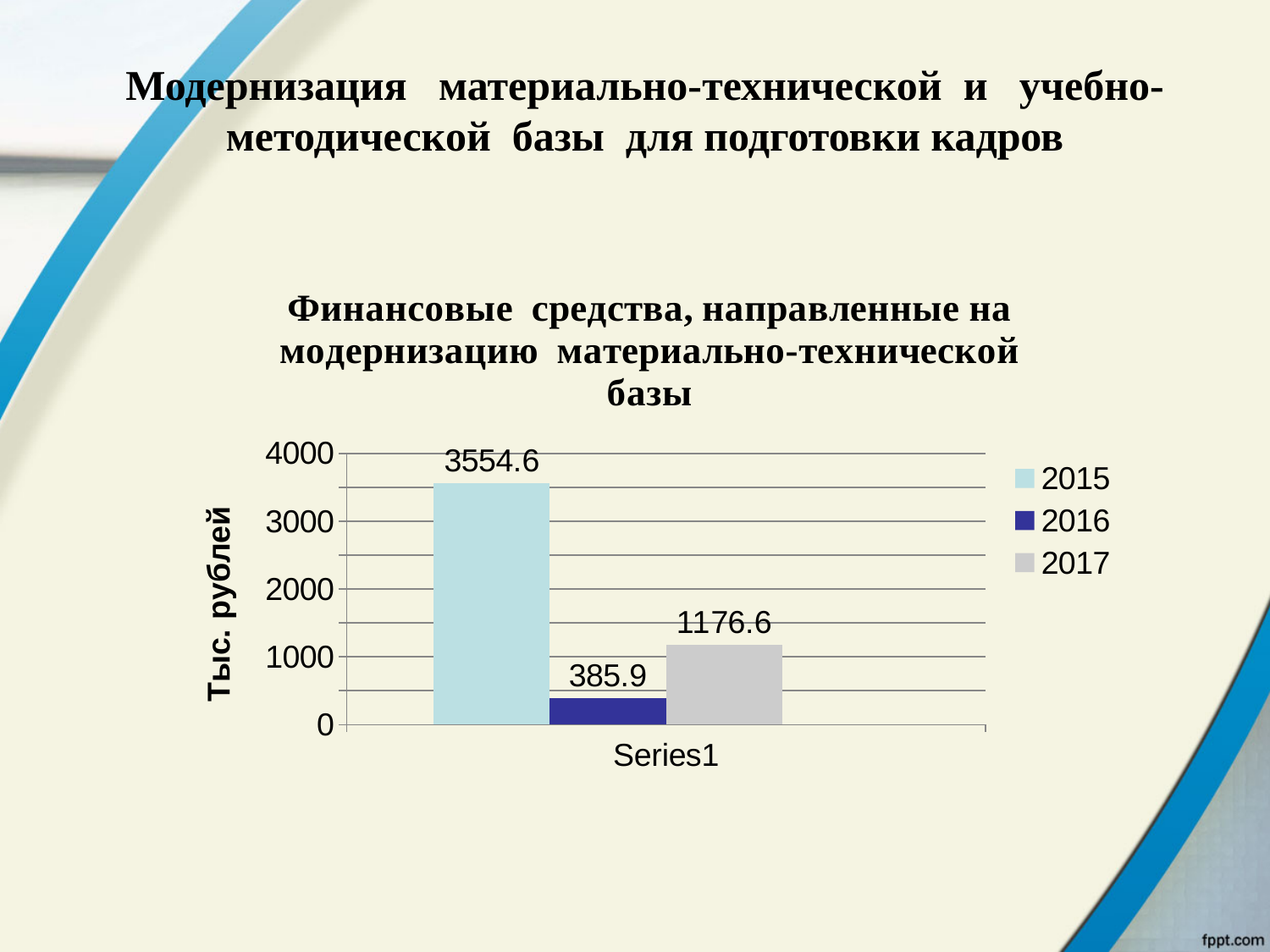
Is the value for 2015 greater or less than 3000? greater How many series does the legend list? 3 What is the value for 2015? 3554.6 Which year has the lowest value? 2016 What is the difference between the values for 2017 and 2016? 790.7 Which is larger, the value for 2016 or the value for 2017? 2017 What is the difference between the values for 2015 and 2017? 2378 What kind of chart is shown on the slide? bar chart What is the label of the vertical axis? Тыс. рублей What is the value for 2017? 1176.6 Which year has the highest value? 2015 What is the value for 2016? 385.9